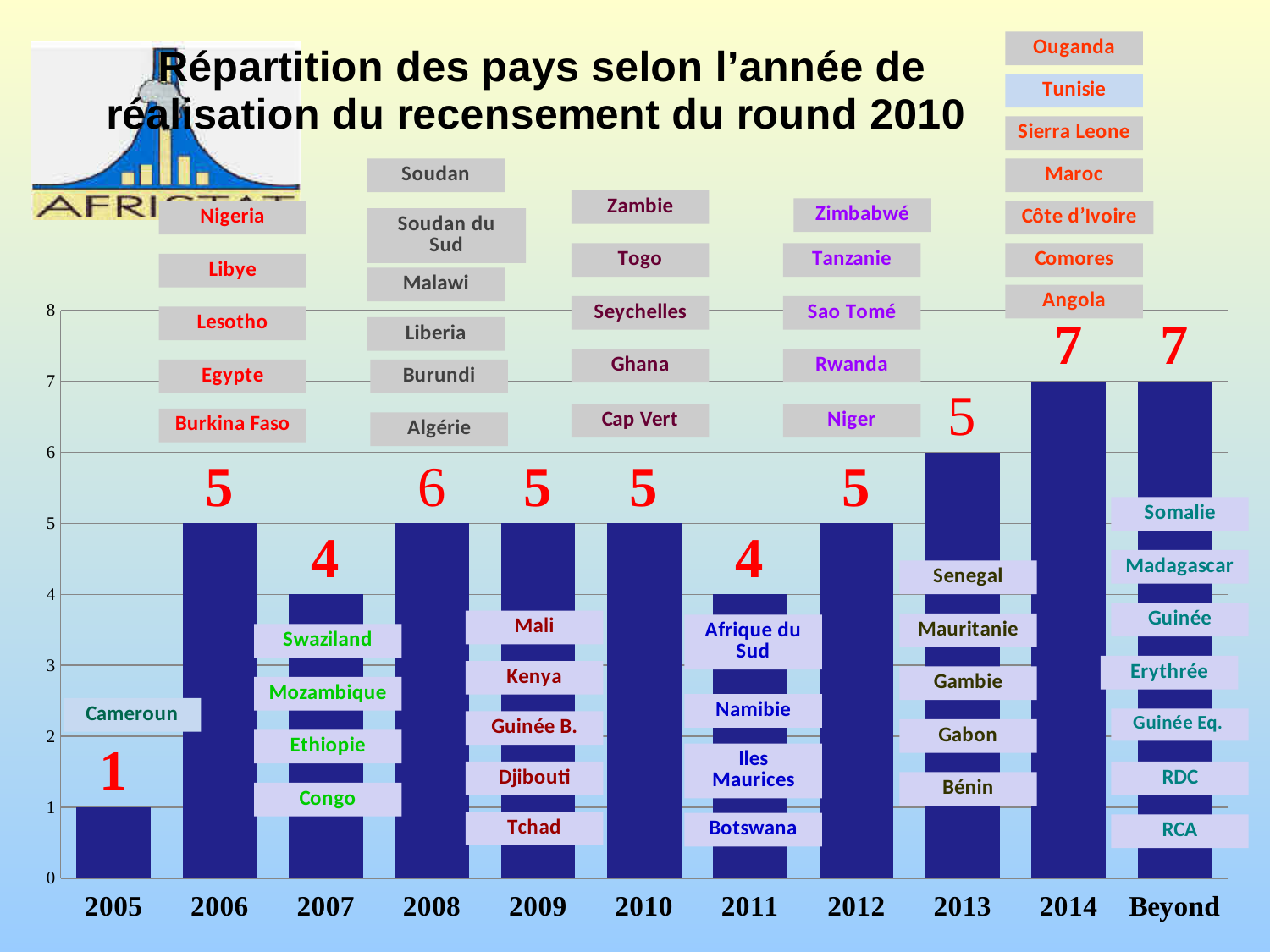
What is the value for 2014? 7 Which category has the lowest value? 2005 What is the title of the chart? Répartition des pays selon l'année de réalisation du recensement du round 2010 How many categories are shown on the x axis? 11 What is the value for 2005? 1 Is the value for 2014 greater or less than 6? greater What kind of chart is shown on the slide? bar chart What is the difference between the values for 2014 and 2005? 6 What is the value for 2011? 4